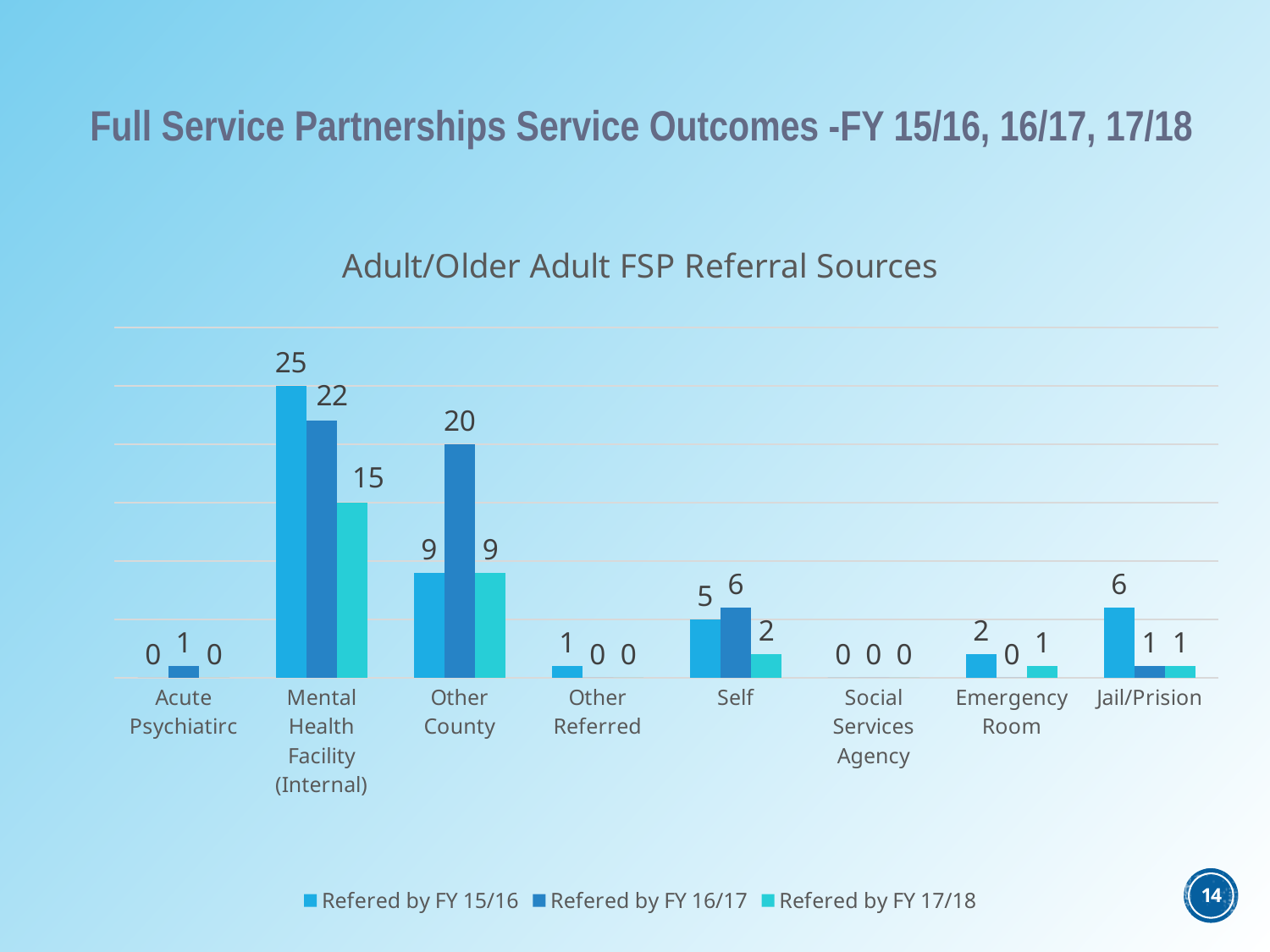
What is the difference between the Refered by FY 15/16 and Refered by FY 17/18 values for Mental Health Facility (Internal)? 10 How many series does the legend list? 3 Which category has the highest value in the Refered by FY 17/18 series? Mental Health Facility (Internal) What is the value for Mental Health Facility (Internal) in the Refered by FY 15/16 series? 25 What is the value for Other County in the Refered by FY 16/17 series? 20 What is the title of the chart? Adult/Older Adult FSP Referral Sources Which category has a value of 0 in all three series? Social Services Agency Which is larger for Other County: the Refered by FY 16/17 value or the Refered by FY 17/18 value? Refered by FY 16/17 What is the total of the three series values for Self? 13 How many referral source categories are shown on the x axis? 8 What is the value for Jail/Prision in the Refered by FY 15/16 series? 6 What type of chart is shown on the slide? Bar chart